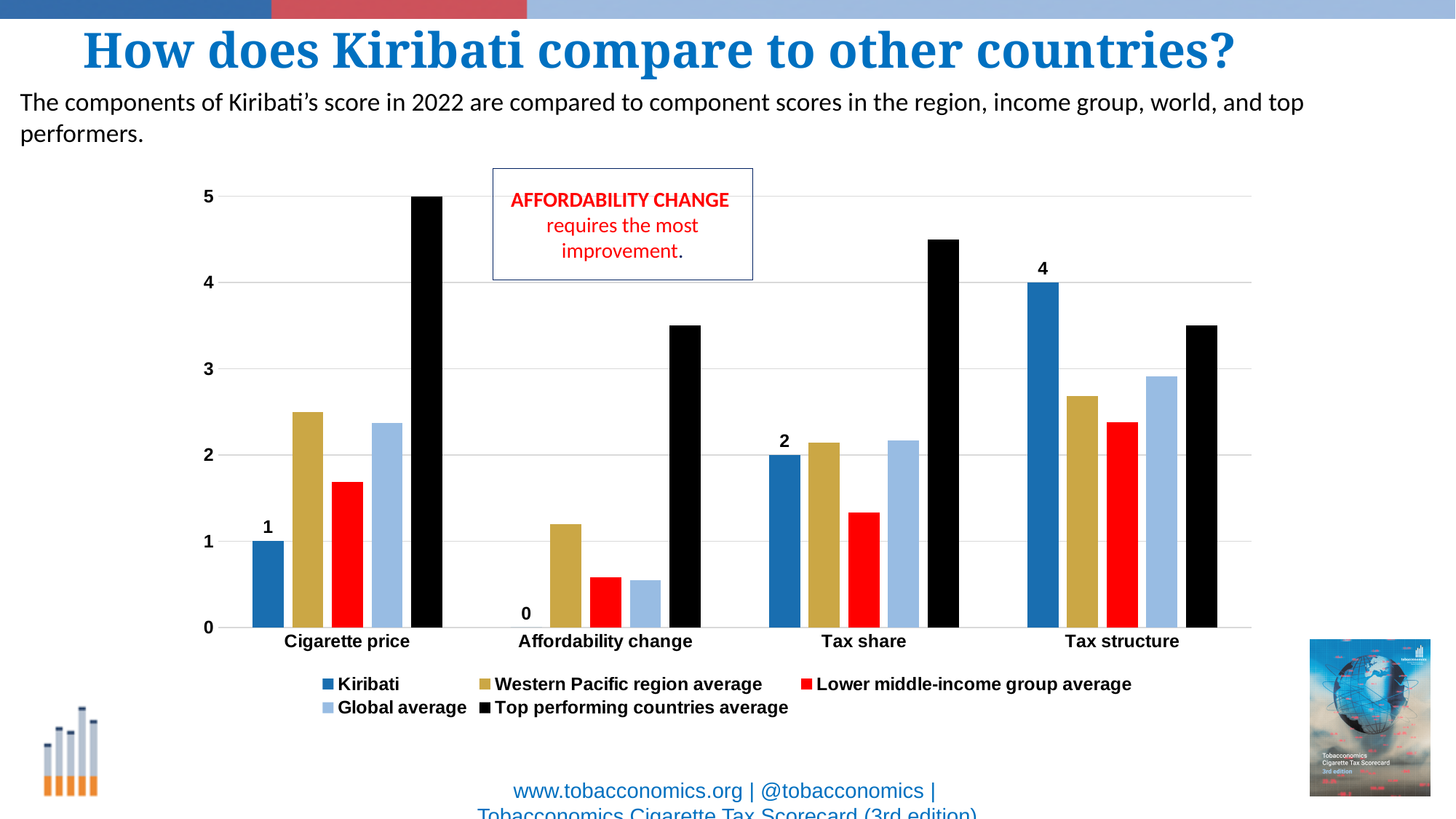
Is the Lower middle-income group average for Affordability change greater or less than 1? less What is Kiribati's score for Affordability change? 0 What is Kiribati's score for Cigarette price? 1 What kind of chart is shown on the slide? Bar chart How many series does the legend list? 5 What is Kiribati's score for Tax structure? 4 In which component does Kiribati have its lowest score? Affordability change For Cigarette price, which is larger: Kiribati's score or the Western Pacific region average? Western Pacific region average What is the difference between Kiribati's Tax structure score and its Cigarette price score? 3 What is the Top performing countries average score for Cigarette price? 5 In which component does Kiribati have its highest score? Tax structure Is the Top performing countries average for Tax share greater or less than 4? greater